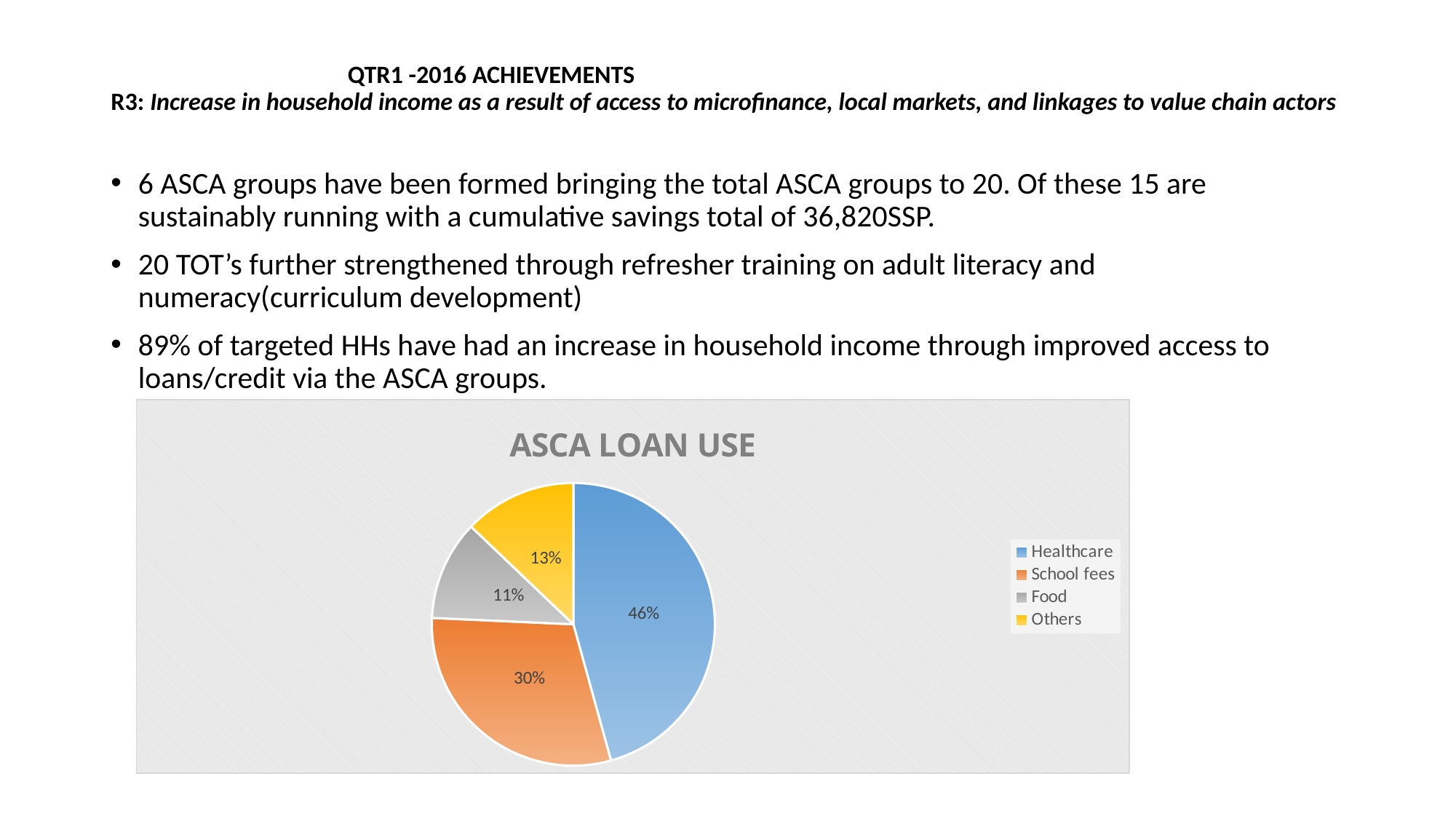
What share of ASCA loan use goes to Others? 13% What share of ASCA loan use goes to Healthcare? 46% Which has a larger share of ASCA loan use, Food or Others? Others What kind of chart is shown on the slide? Pie chart What share of ASCA loan use goes to School fees? 30% Which category has the largest share of ASCA loan use? Healthcare What colour is the School fees slice in the pie chart? Orange Which category has the smallest share of ASCA loan use? Food What is the difference in percentage points between the Healthcare and School fees shares? 16 How many categories does the pie chart show? 4 What is the title of the chart? ASCA LOAN USE